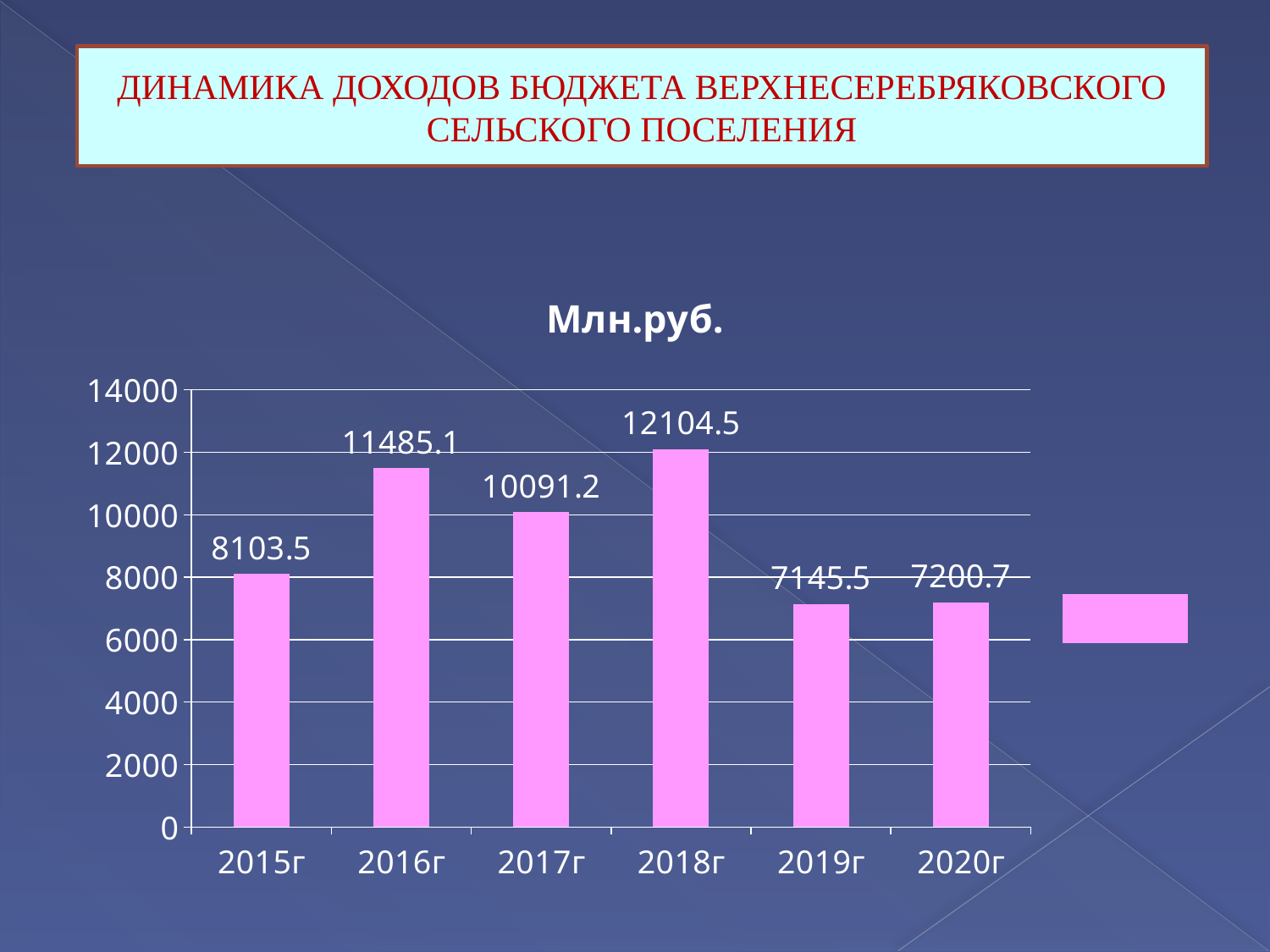
What kind of chart is shown on the slide? bar chart What is the difference between the values for 2016г and 2015г? 3381.6 What is the value for 2018г? 12104.5 What is the difference between the values for 2018г and 2019г? 4959 What is the value for 2015г? 8103.5 Which year has the highest value? 2018г What is the value for 2020г? 7200.7 How many years are shown on the x axis? 6 Which is larger, the value for 2016г or the value for 2017г? 2016г What is the title of the chart? Млн.руб. Which year has the lowest value? 2019г Is the value for 2017г greater or less than 10000? greater